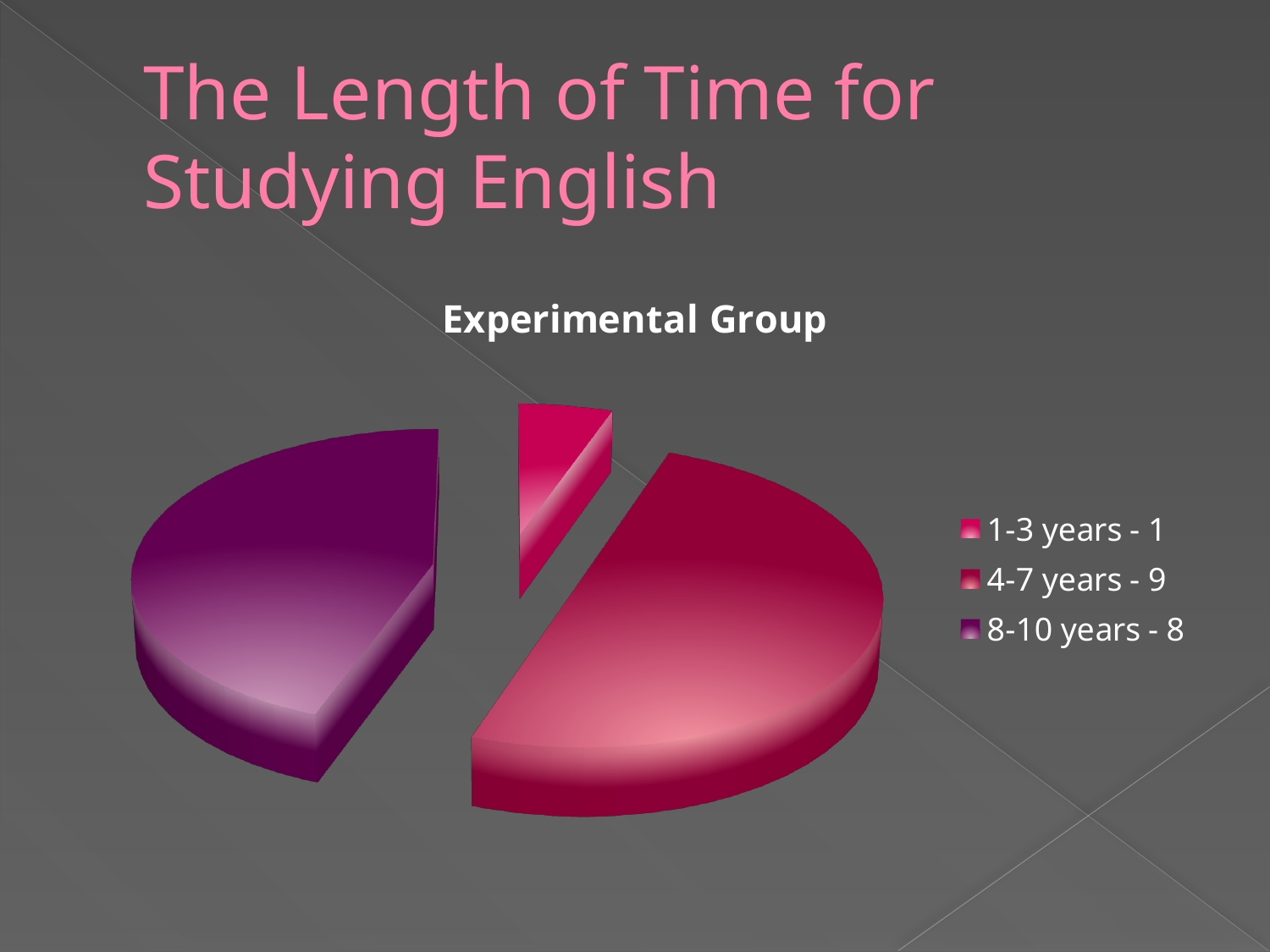
What is the value for the 8-10 years category? 8 What is the difference between the values for 4-7 years and 8-10 years? 1 What is the value for the 1-3 years category? 1 What is the total of all the values in the pie chart? 18 Which category has the largest value? 4-7 years Which category has the smallest value? 1-3 years How many categories does the pie chart have? 3 What kind of chart is shown on the slide? pie chart What is the difference between the values for 8-10 years and 1-3 years? 7 What is the title of the chart? Experimental Group Which is larger, the value for 8-10 years or the value for 1-3 years? 8-10 years What is the value for the 4-7 years category? 9